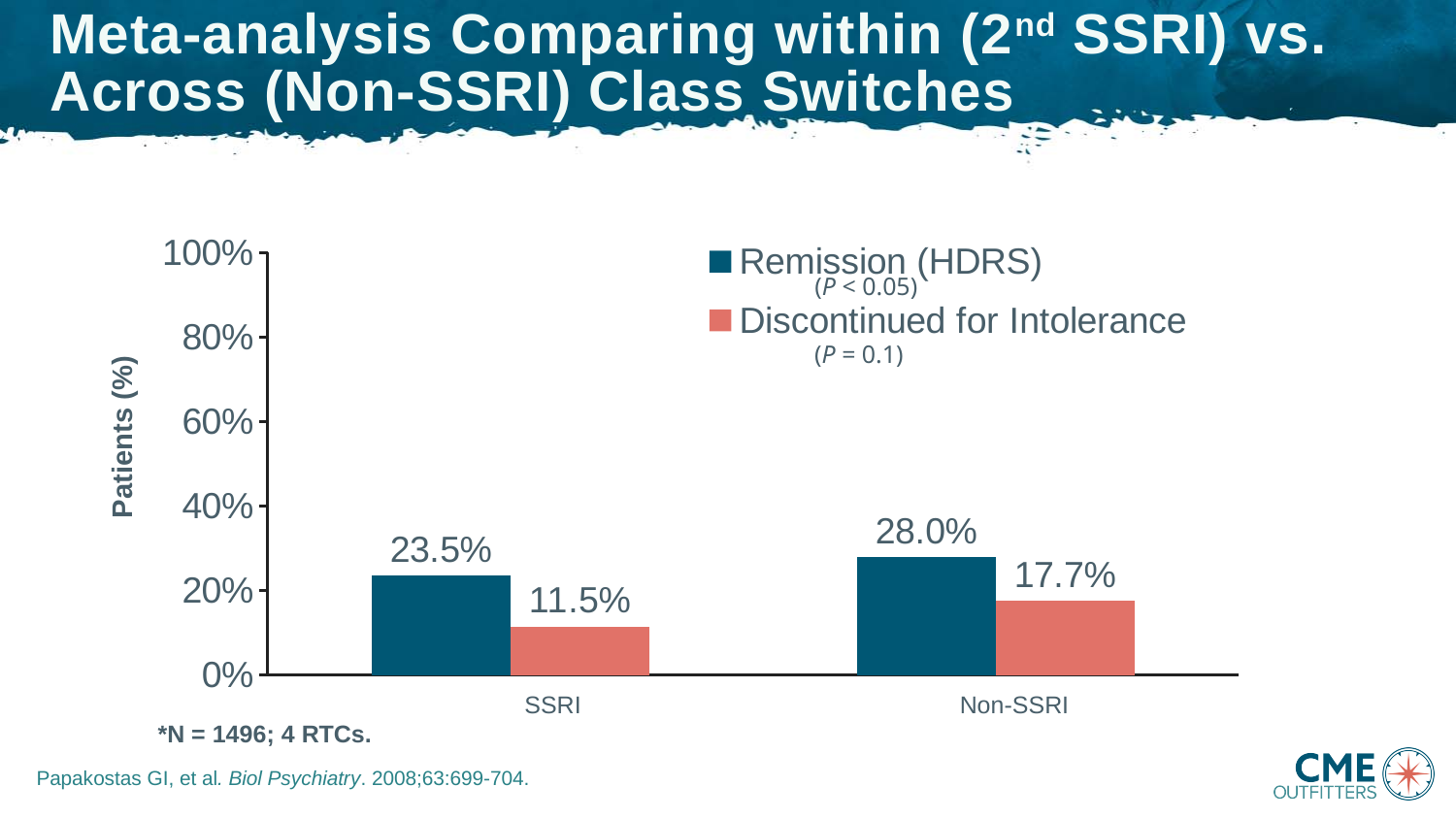
What is the Remission (HDRS) value for SSRI? 23.5% What is the Discontinued for Intolerance value for Non-SSRI? 17.7% How many series does the legend list? 2 Which category has the higher Remission (HDRS) value? Non-SSRI What is the difference between the Discontinued for Intolerance values for Non-SSRI and SSRI? 6.2% What is the difference between the Remission (HDRS) values for Non-SSRI and SSRI? 4.5% How many categories are shown on the x axis? 2 What is the Discontinued for Intolerance value for SSRI? 11.5% What kind of chart is shown on the slide? Bar chart Is the Remission (HDRS) value for SSRI greater or less than 20%? greater What is the Remission (HDRS) value for Non-SSRI? 28.0% Which bar on the chart has the lowest value? Discontinued for Intolerance for SSRI